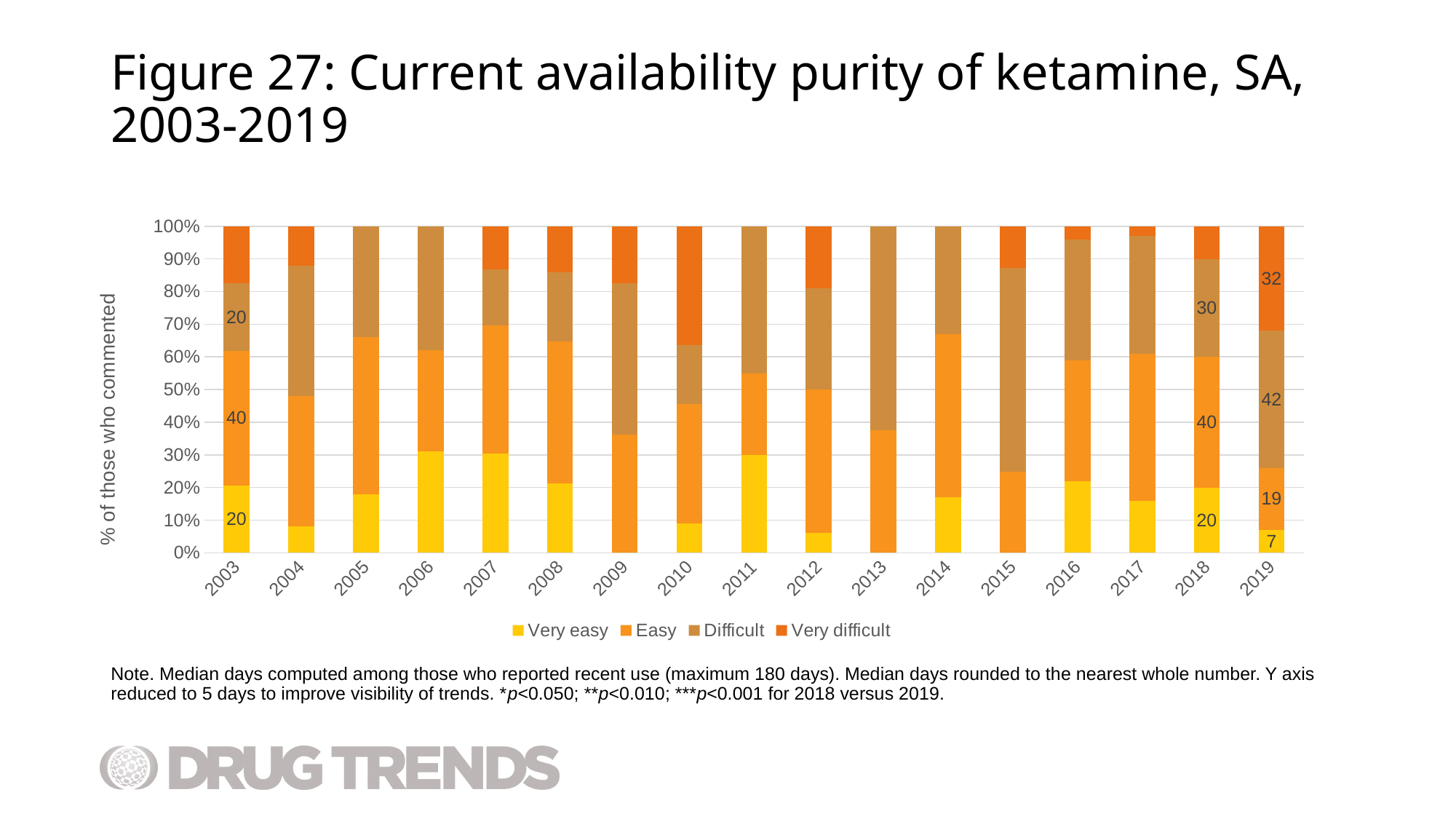
How many years are shown along the x axis of the chart? 17 What is the Difficult value for 2018? 30 Is the Very easy value for 2012 greater or less than 10%? less In 2019, which is larger: the Difficult value or the Easy value? Difficult What kind of chart is shown on the slide? Stacked bar chart What is the Easy value for 2003? 40 In 2019, what is the difference between the Difficult value and the Very easy value? 35 What is the label on the y axis of the chart? % of those who commented What is the Very difficult value for 2019? 32 What is the Difficult value for 2019? 42 What is the Very easy value for 2019? 7 How many series does the legend list? 4